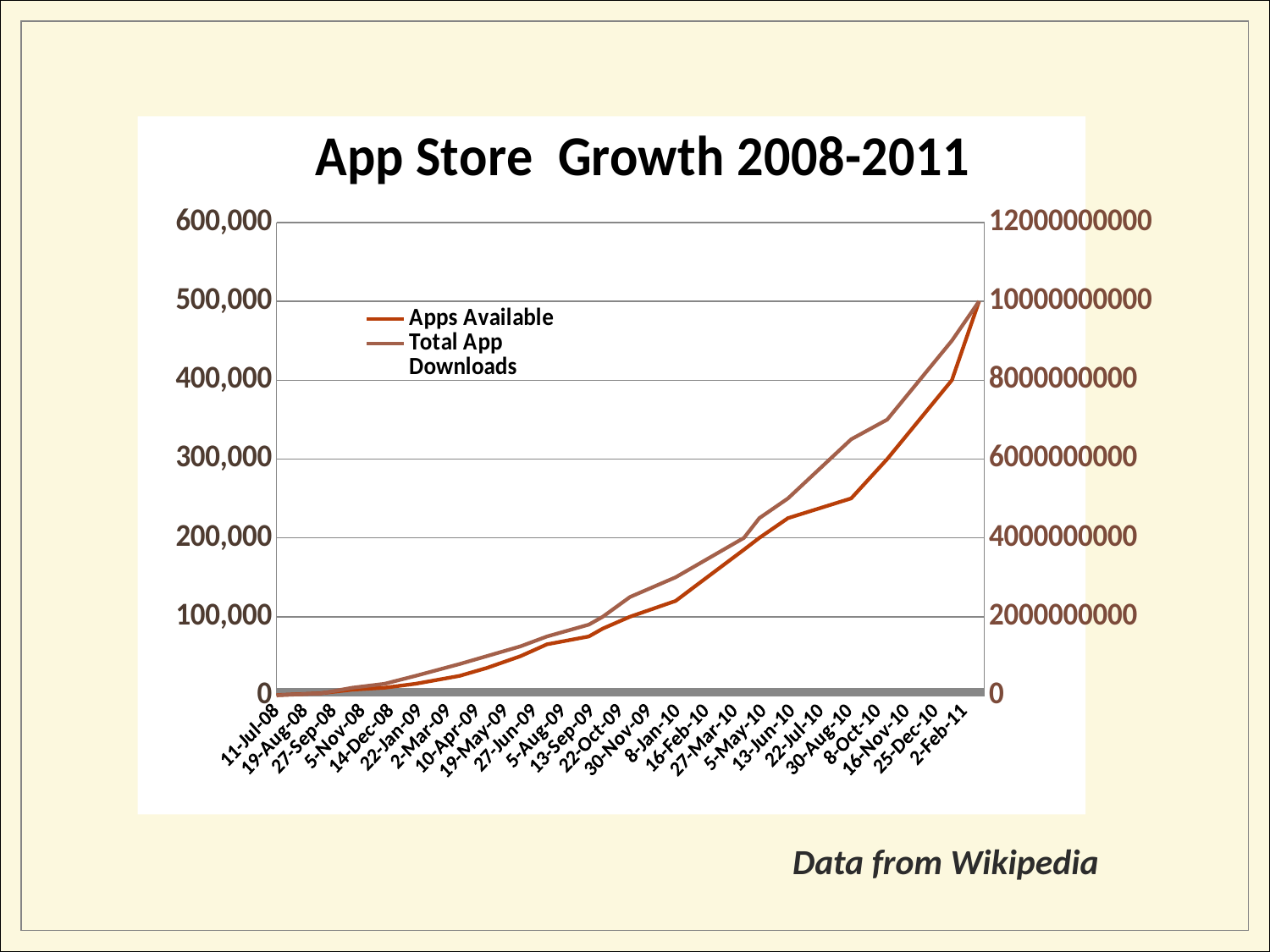
At which date is the Apps Available value highest? 2-Feb-11 How many date labels are shown on the x axis? 25 Do the Total App Downloads values rise or fall along the x axis? rise What is the title of the chart? App Store Growth 2008-2011 What kind of chart is shown on the slide? line chart Which two series are listed in the legend? Apps Available and Total App Downloads How many series does the legend list? 2 Do the Apps Available values rise or fall from 11-Jul-08 to 2-Feb-11? rise At which date is the Apps Available value lowest? 11-Jul-08 Is the Apps Available value at 8-Oct-10 greater or less than 200,000? greater Is the Apps Available value at 13-Sep-09 greater or less than 100,000? less Is the Total App Downloads value at 8-Oct-10 greater or less than 6000000000? greater